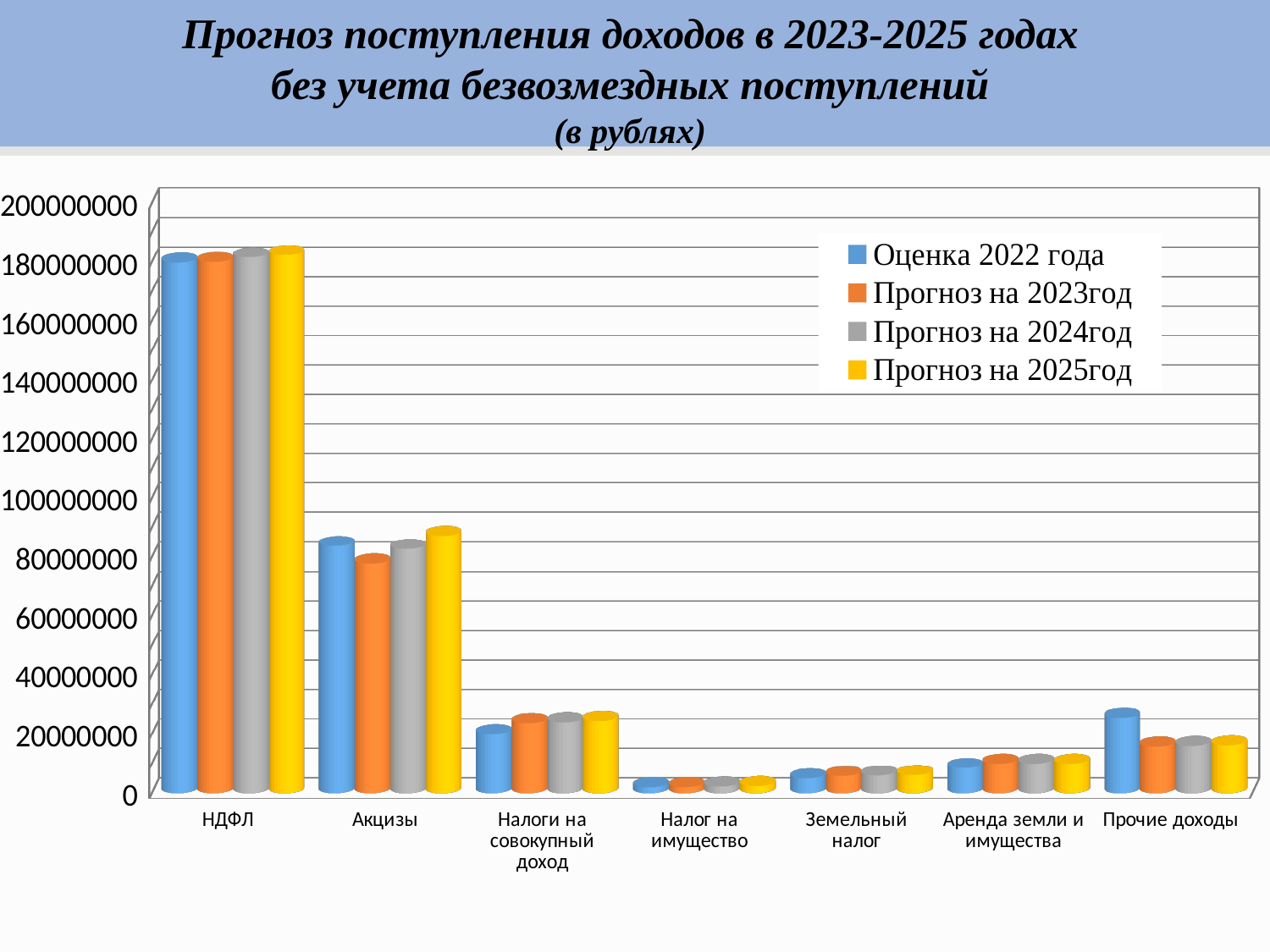
What kind of chart is shown on the slide? Bar chart For Прочие доходы, which is larger: Оценка 2022 года or Прогноз на 2023год? Оценка 2022 года How many categories are shown on the x axis? 7 Is the value for Прочие доходы in Оценка 2022 года greater or less than 20000000? greater For Акцизы, which is larger: Прогноз на 2023год or Прогноз на 2025год? Прогноз на 2025год Is the value for Земельный налог in Прогноз на 2023год greater or less than 20000000? less Is the value for Акцизы in Прогноз на 2025год greater or less than 80000000? greater How many series does the legend list? 4 Which colour represents Прогноз на 2024год in the legend? Grey Which category has the lowest value for Прогноз на 2025год? Налог на имущество Which category has the highest value for Оценка 2022 года? НДФЛ